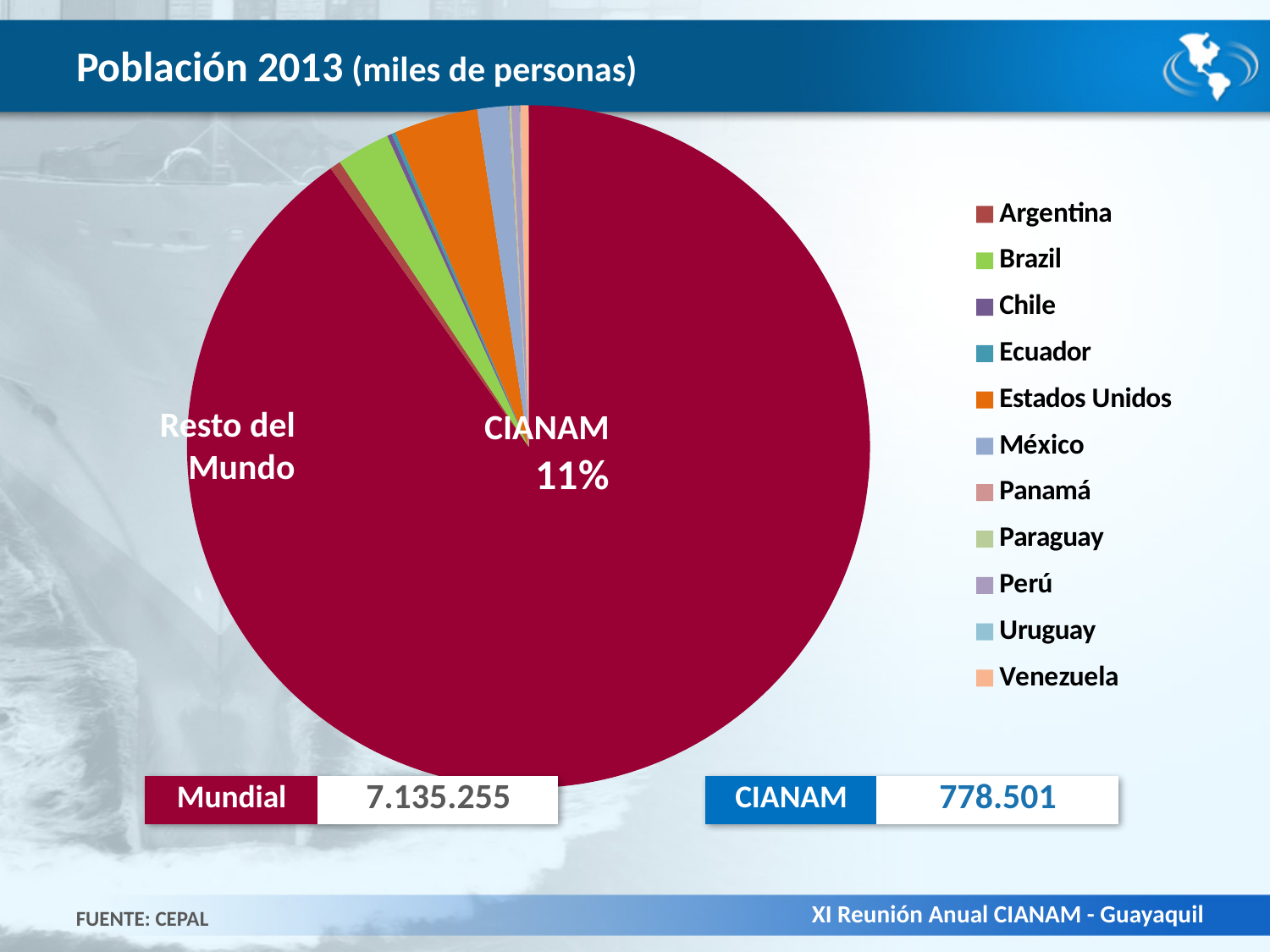
How many entries does the legend of the pie chart list? 11 What share of the pie does CIANAM represent? 11% What is the value shown for Mundial? 7.135.255 Which slice of the pie is the largest? Resto del Mundo What kind of chart is shown on the slide? pie chart What colour represents Estados Unidos in the legend? orange What is the difference between the Mundial value and the CIANAM value? 6.356.754 What is the value shown for CIANAM? 778.501 What is the title of the chart on the slide? Población 2013 (miles de personas) Which has a larger slice of the pie, Estados Unidos or Brazil? Estados Unidos Among the CIANAM countries in the legend, which one has the largest slice of the pie? Estados Unidos Which legend entry comes first in the legend? Argentina